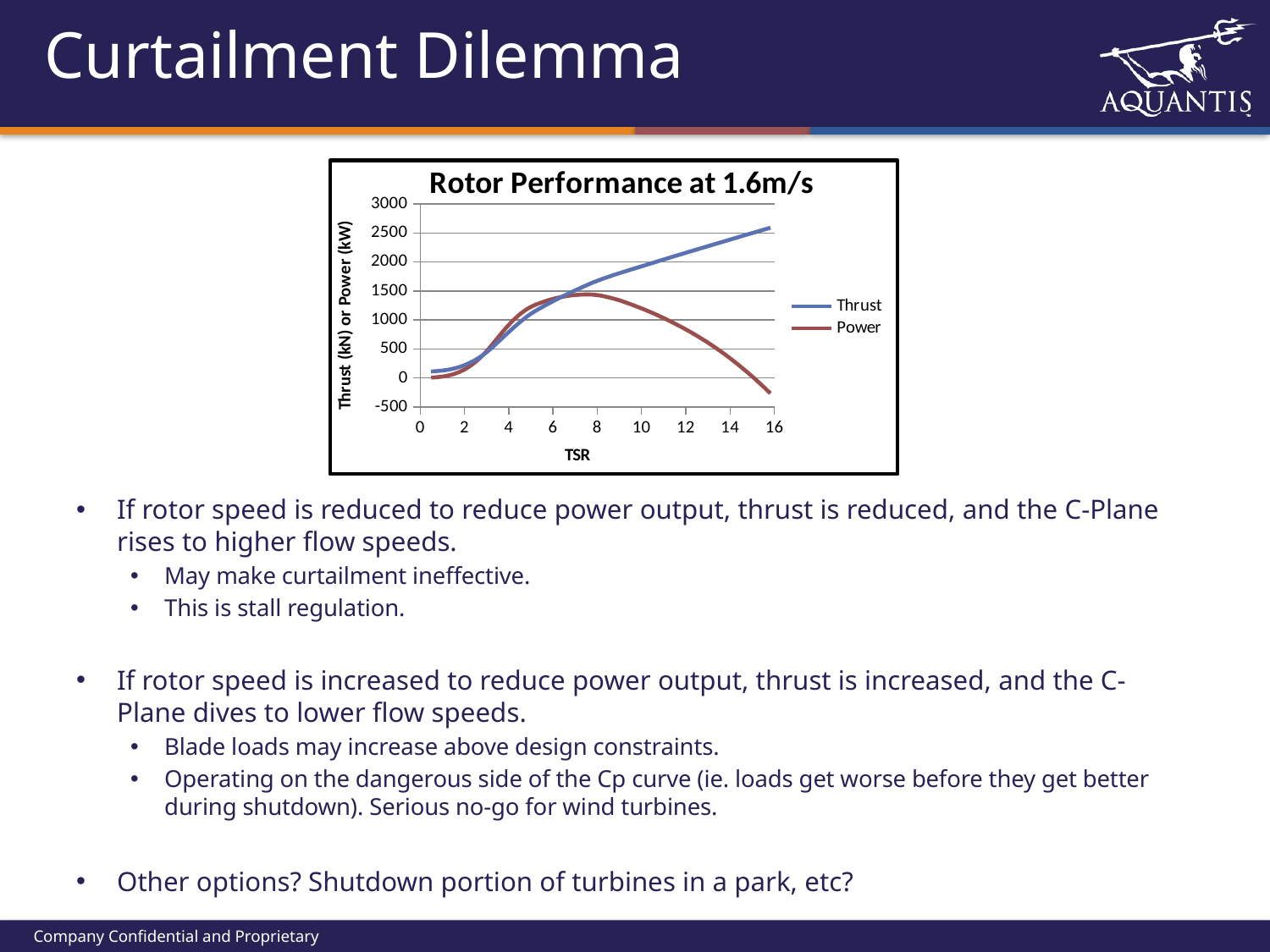
Is the Thrust value at TSR 8 greater or less than 1500? greater At TSR 14, which series has the higher value, Thrust or Power? Thrust What is the title of the chart? Rotor Performance at 1.6m/s Is the Thrust value at TSR 12 greater or less than 2000? greater Is the Power value at TSR 16 greater or less than 0? less What kind of chart is shown on the slide? line chart Does the Thrust series rise or fall as TSR increases from 8 to 16? rise What is the label on the x axis of the chart? TSR How many series does the chart's legend list? 2 Does the Power series rise or fall as TSR increases from 8 to 16? fall